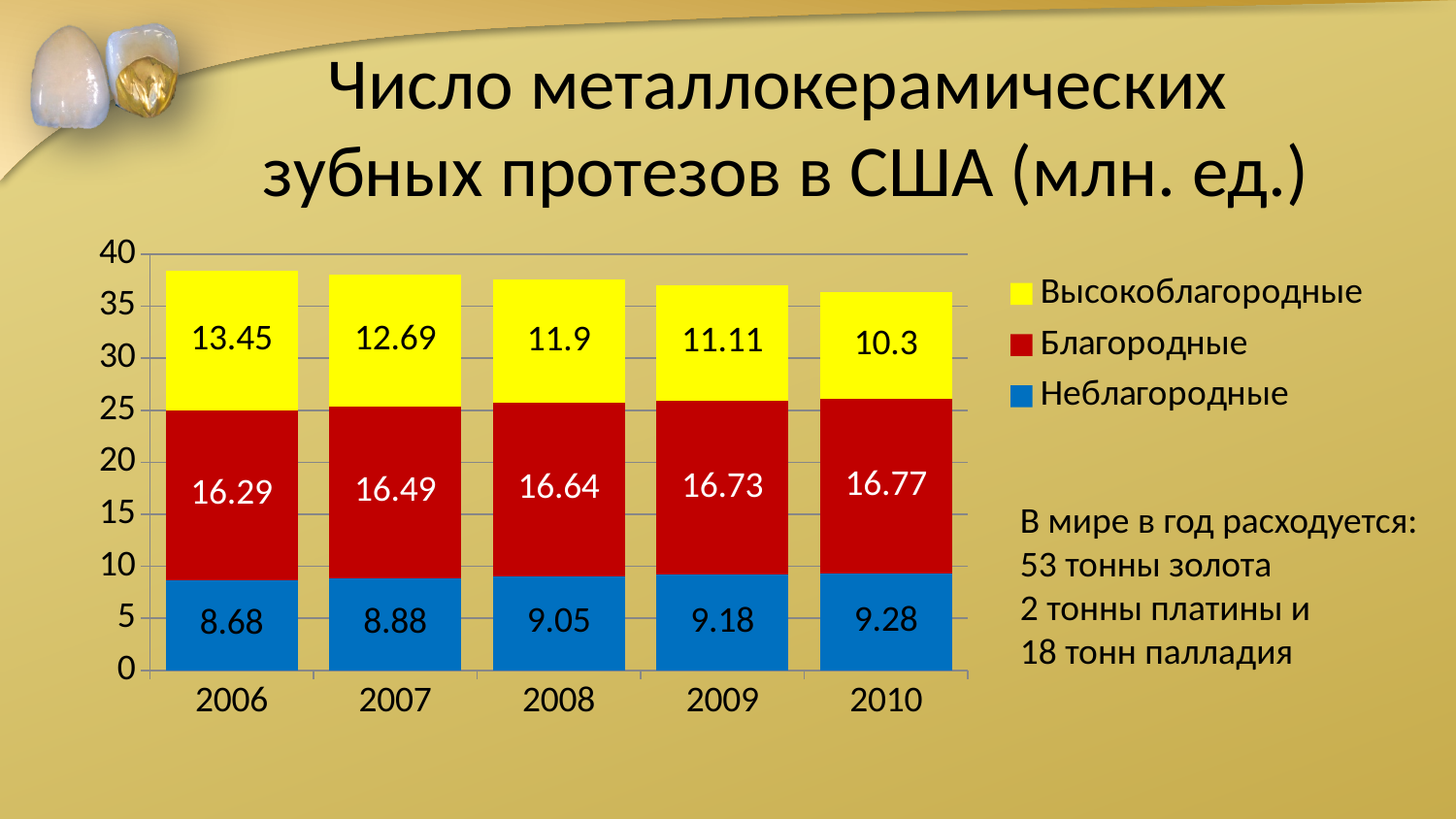
In which year is the Высокоблагородные value lowest? 2010 What is the value for Благородные in 2009? 16.73 What is the value for Высокоблагородные in 2006? 13.45 Which is larger: Благородные in 2006 or Благородные in 2010? Благородные in 2010 What is the difference between the Высокоблагородные values in 2006 and 2010? 3.15 What is the value for Неблагородные in 2010? 9.28 How many years are shown on the x axis? 5 What type of chart is shown on the slide? Stacked bar chart How many series does the legend list? 3 In which year is the Неблагородные value highest? 2010 What is the total of the stacked bar for 2006? 38.42 Do the Высокоблагородные values rise or fall from 2006 to 2010? Fall